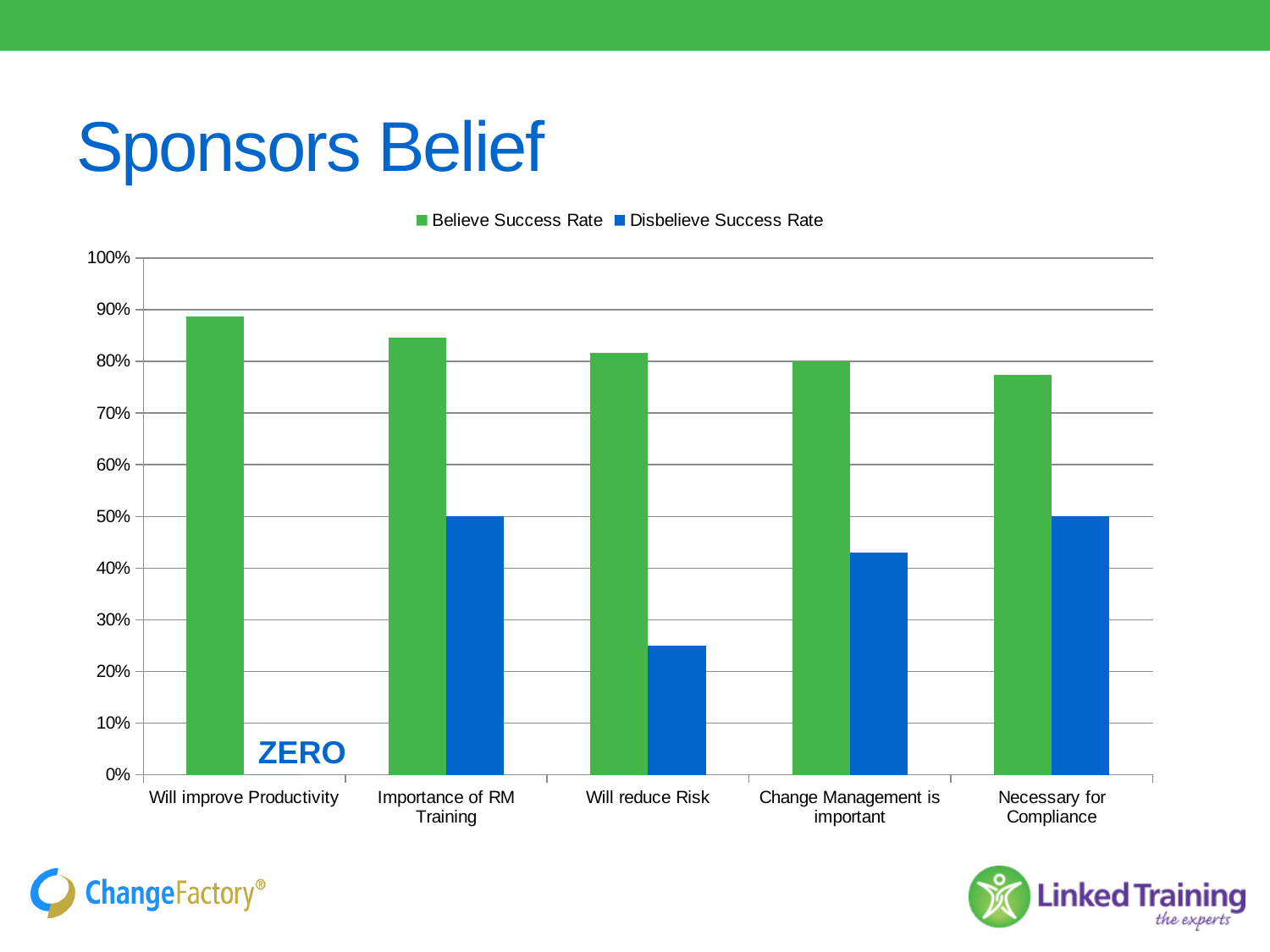
How many series does the legend list? 2 Which category has the highest Believe Success Rate? Will improve Productivity Which category has the lowest Disbelieve Success Rate? Will improve Productivity Does the Believe Success Rate rise or fall from left to right across the categories? fall Which category has the lowest Believe Success Rate? Necessary for Compliance What is the Disbelieve Success Rate for Importance of RM Training? 50% Is the Disbelieve Success Rate for Change Management is important greater or less than 40%? greater What kind of chart is shown on the slide? bar chart Is the Disbelieve Success Rate for Will reduce Risk greater or less than 30%? less How many categories are shown on the x axis? 5 For Will reduce Risk, which is larger: the Believe Success Rate or the Disbelieve Success Rate? Believe Success Rate Is the Believe Success Rate for Will improve Productivity greater or less than 80%? greater